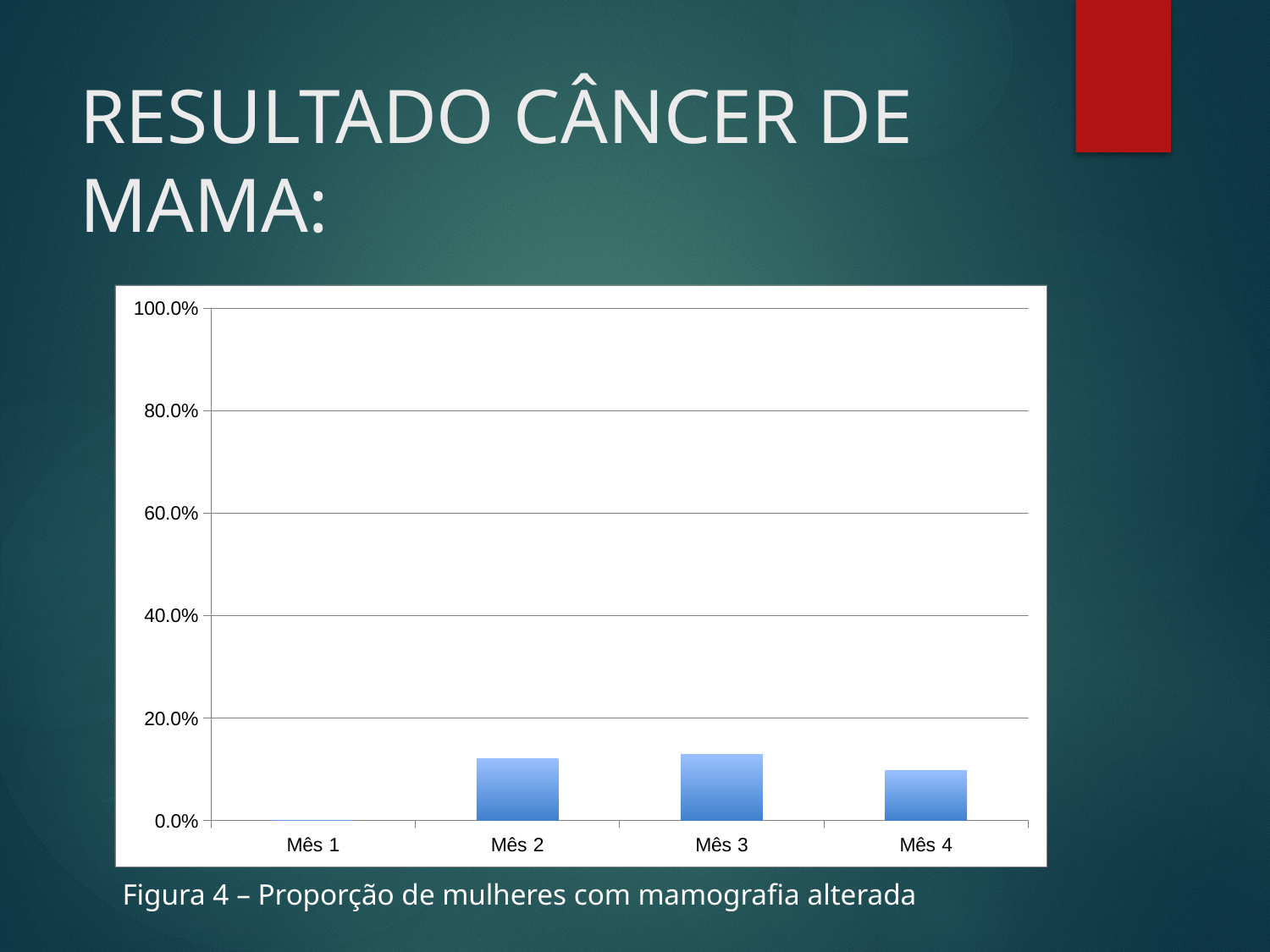
Among Mês 2, Mês 3 and Mês 4, which month has the lowest value? Mês 4 Which is larger, the value for Mês 2 or the value for Mês 4? Mês 2 Is the value for Mês 4 greater or less than 20.0%? less What is the highest value shown on the y axis of the chart? 100.0% How many categories are shown on the x axis of the chart? 4 Which is larger, the value for Mês 3 or the value for Mês 4? Mês 3 Which month on the x axis has no visible bar? Mês 1 Is the value for Mês 2 greater or less than 20.0%? less What kind of chart is shown on the slide? bar chart Is the value for Mês 3 greater or less than 20.0%? less